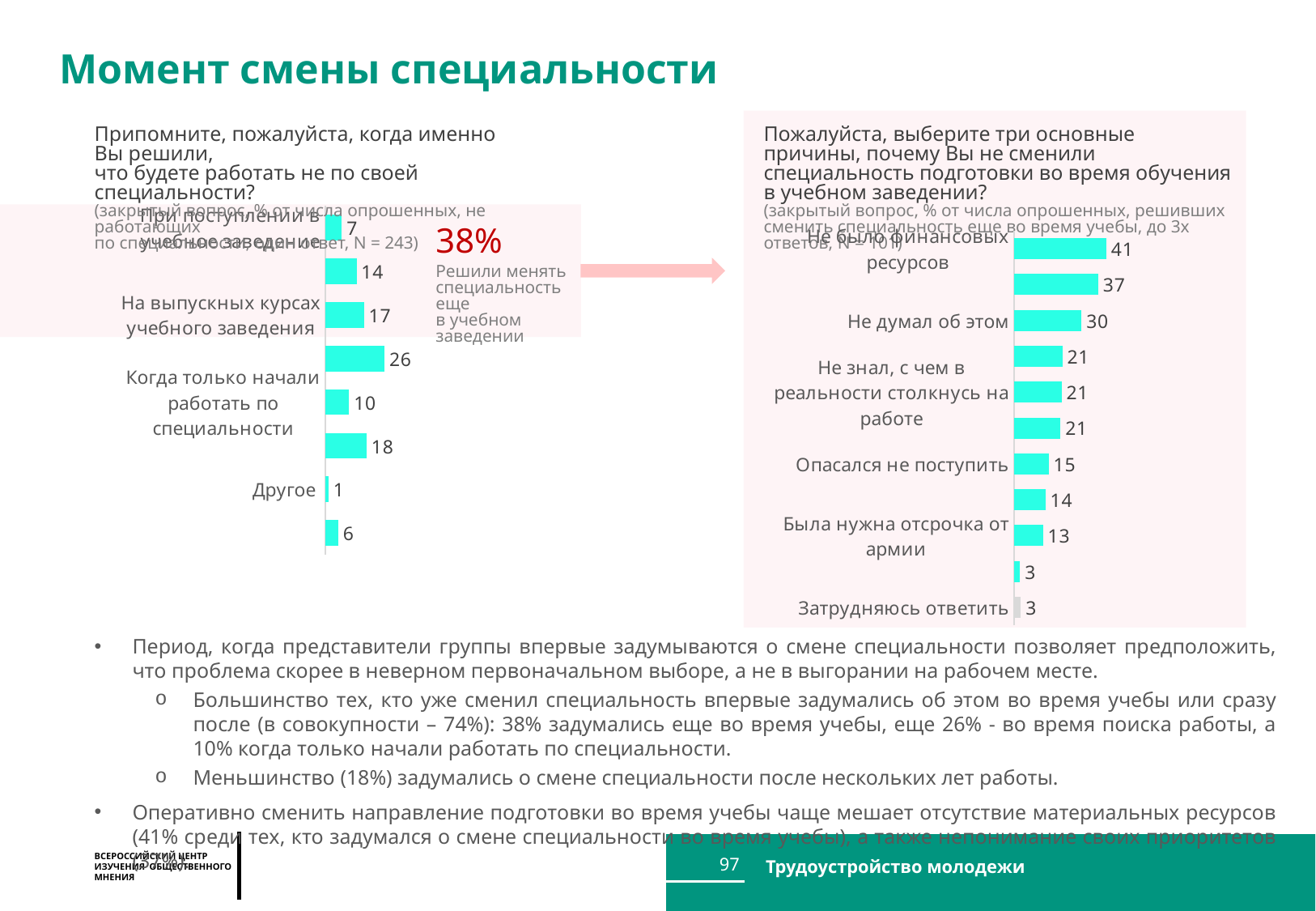
How many bars are plotted in the right-hand chart? 11 In the right-hand chart, what is the value for 'Не было финансовых ресурсов'? 41 In the right-hand chart, what is the difference between the values for 'Не было финансовых ресурсов' and 'Не думал об этом'? 11 In the right-hand chart, what is the value for 'Опасался не поступить'? 15 What kind of chart is the chart on the left of the slide? bar chart What percentage is highlighted in red next to the left-hand chart? 38% In the left-hand chart, what is the value for 'Другое'? 1 In the right-hand chart, what is the value for 'Затрудняюсь ответить'? 3 In the left-hand chart, what is the value for 'На выпускных курсах учебного заведения'? 17 In the right-hand chart, which is larger: the value for 'Не думал об этом' or the value for 'Опасался не поступить'? Не думал об этом In the right-hand chart, what is the value for 'Не думал об этом'? 30 In the right-hand chart, which category has the highest value? Не было финансовых ресурсов